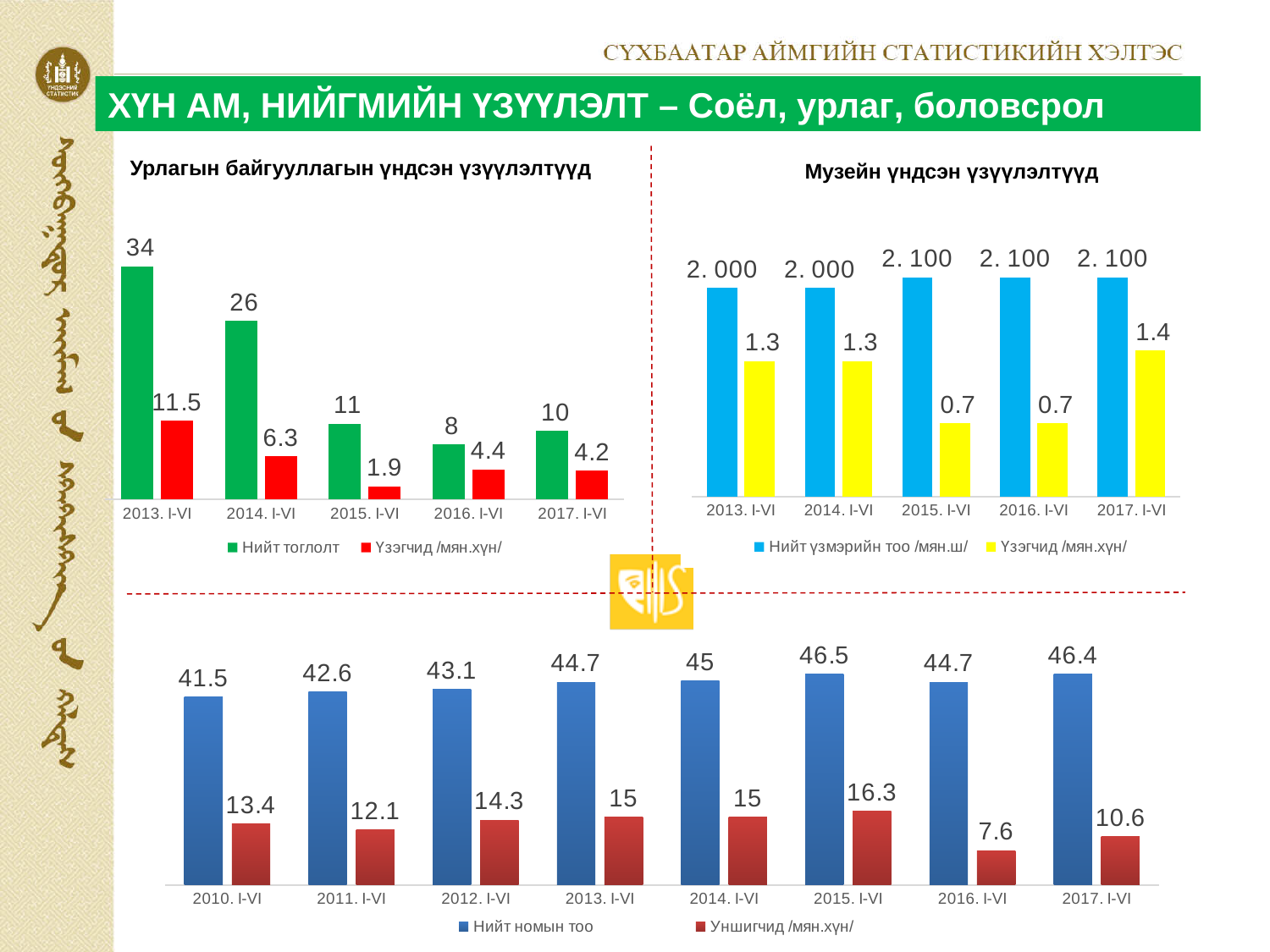
In the bottom chart, what is the value of Нийт номын тоо for 2015. I-VI? 46.5 In the chart titled 'Урлагын байгууллагын үндсэн үзүүлэлтүүд', how many series does the legend list? 2 In the chart titled 'Урлагын байгууллагын үндсэн үзүүлэлтүүд', what is the value of Нийт тоглолт for 2013. I-VI? 34 In the chart titled 'Музейн үндсэн үзүүлэлтүүд', what is the value of Үзэгчид /мян.хүн/ for 2017. I-VI? 1.4 In the chart titled 'Музейн үндсэн үзүүлэлтүүд', is Үзэгчид /мян.хүн/ larger in 2013. I-VI or in 2015. I-VI? 2013. I-VI In the chart titled 'Урлагын байгууллагын үндсэн үзүүлэлтүүд', which period has the lowest value for Нийт тоглолт? 2016. I-VI In the bottom chart, what is the difference between Нийт номын тоо in 2017. I-VI and 2010. I-VI? 4.9 In the chart titled 'Музейн үндсэн үзүүлэлтүүд', what is the value of Нийт үзмэрийн тоо /мян.ш/ for 2014. I-VI? 2. 000 In the bottom chart, which period has the lowest value for Уншигчид /мян.хүн/? 2016. I-VI What type of chart is the bottom chart? Bar chart In the chart titled 'Урлагын байгууллагын үндсэн үзүүлэлтүүд', what is the difference between Үзэгчид /мян.хүн/ in 2013. I-VI and 2014. I-VI? 5.2 In the chart titled 'Музейн үндсэн үзүүлэлтүүд', how many periods are shown on the x axis? 5